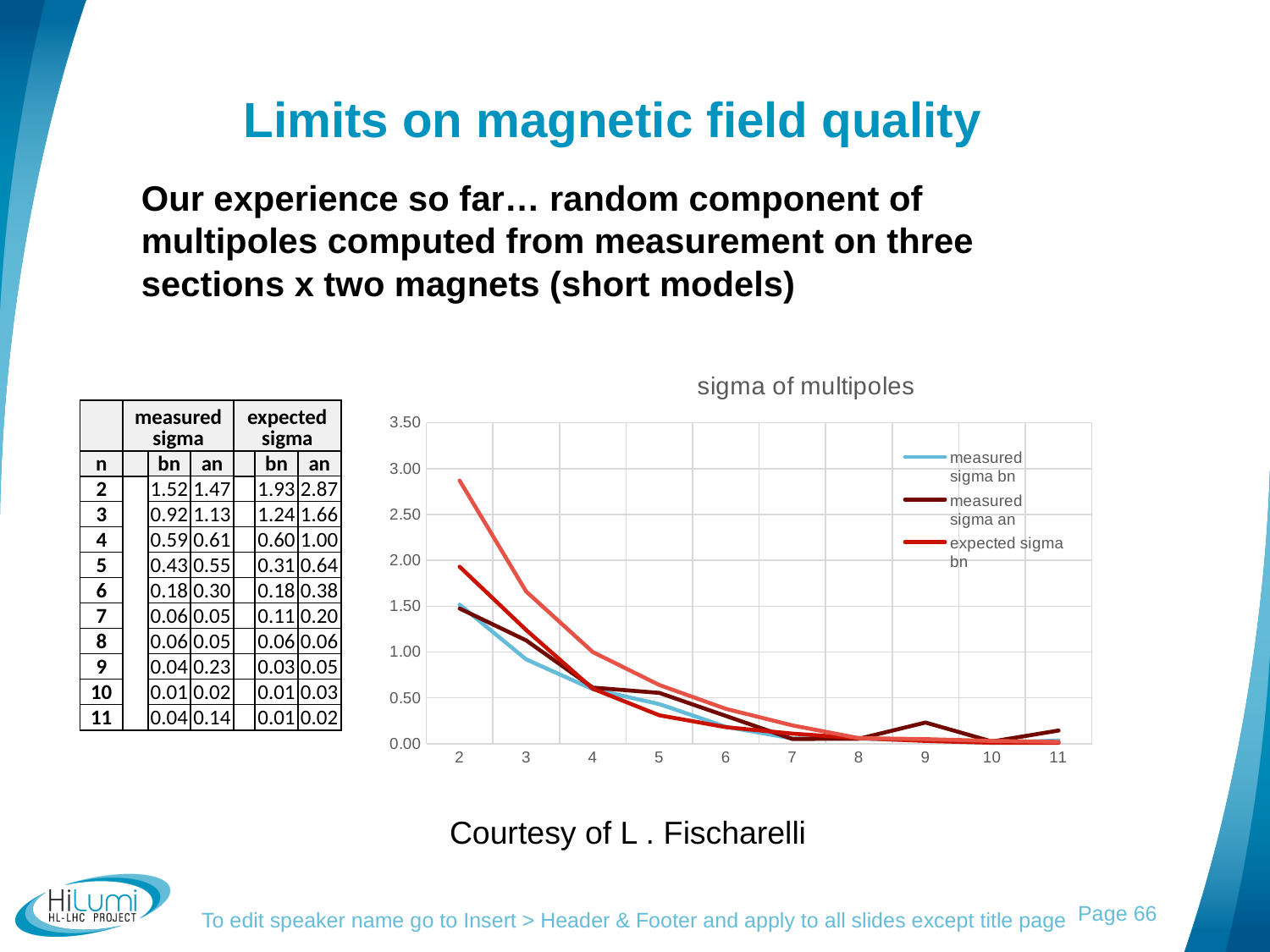
Is the value of measured sigma bn at n = 2 greater or less than 1.00? greater How many series does the chart legend list? 3 Is the value of measured sigma an at n = 9 greater or less than 0.50? less Is the value of expected sigma bn at n = 2 greater or less than 1.50? greater Do the values of the expected sigma bn series rise or fall as n increases along the x axis? fall At n = 2, which is larger: expected sigma bn or measured sigma bn? expected sigma bn At which value of n is the expected sigma bn series highest? 2 What colour is the measured sigma bn line in the chart? light blue What kind of chart is shown on the slide? line chart What is the title of the chart? sigma of multipoles How many points are there along the x axis of the chart? 10